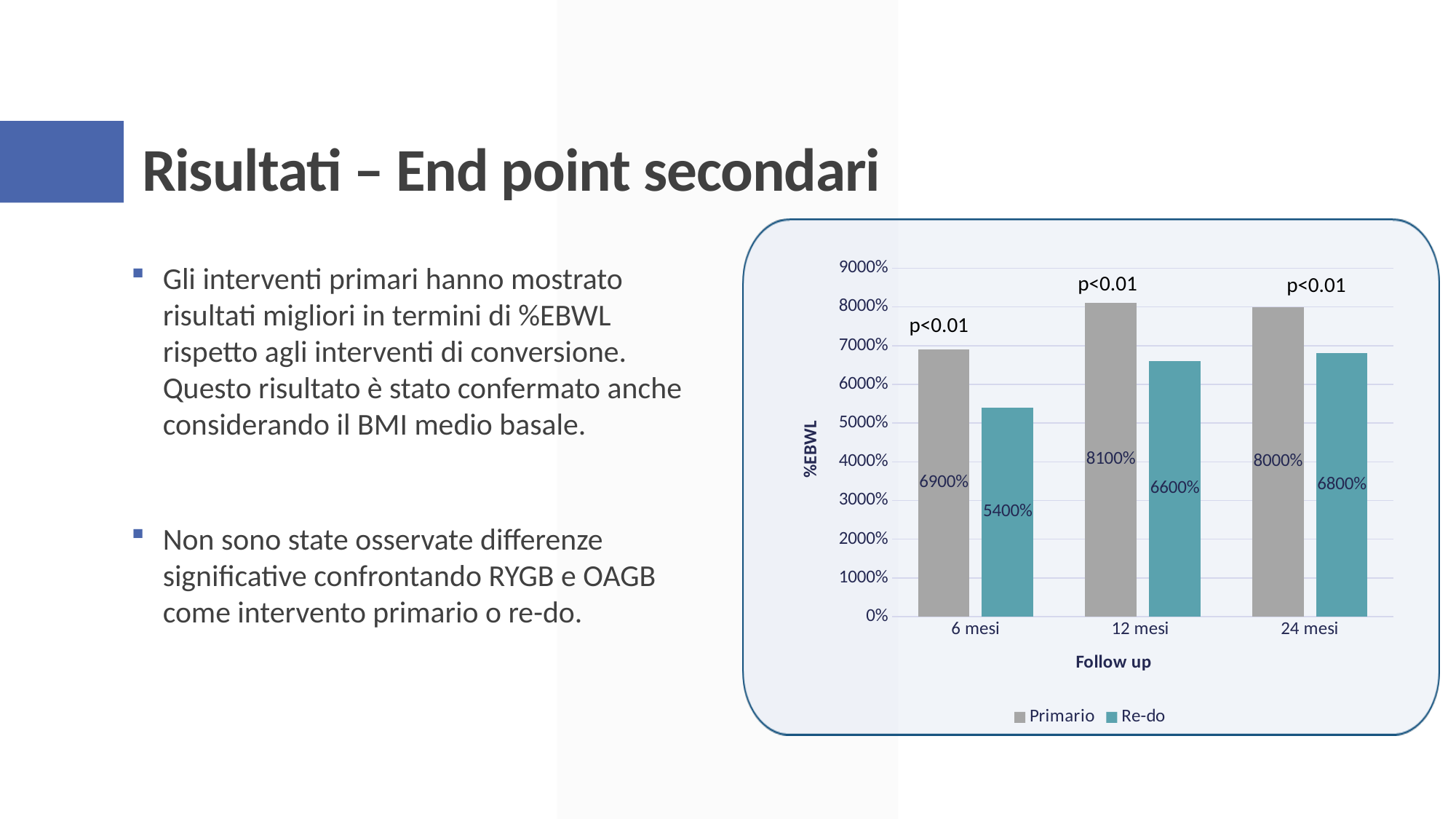
What is the difference between the Primario and Re-do values at 24 mesi? 1200% Which is larger at 12 mesi, Primario or Re-do? Primario How many series does the legend list? 2 What is the %EBWL value for Re-do at 12 mesi? 6600% What kind of chart is shown on the slide? Bar chart What is the %EBWL value for Primario at 6 mesi? 6900% What is the label of the y axis of the chart? %EBWL How many follow-up categories are shown on the x axis? 3 At which follow-up time is the Re-do value lowest? 6 mesi What is the %EBWL value for Re-do at 24 mesi? 6800% At which follow-up time is the Primario value highest? 12 mesi What is the difference between the Primario and Re-do values at 6 mesi? 1500%